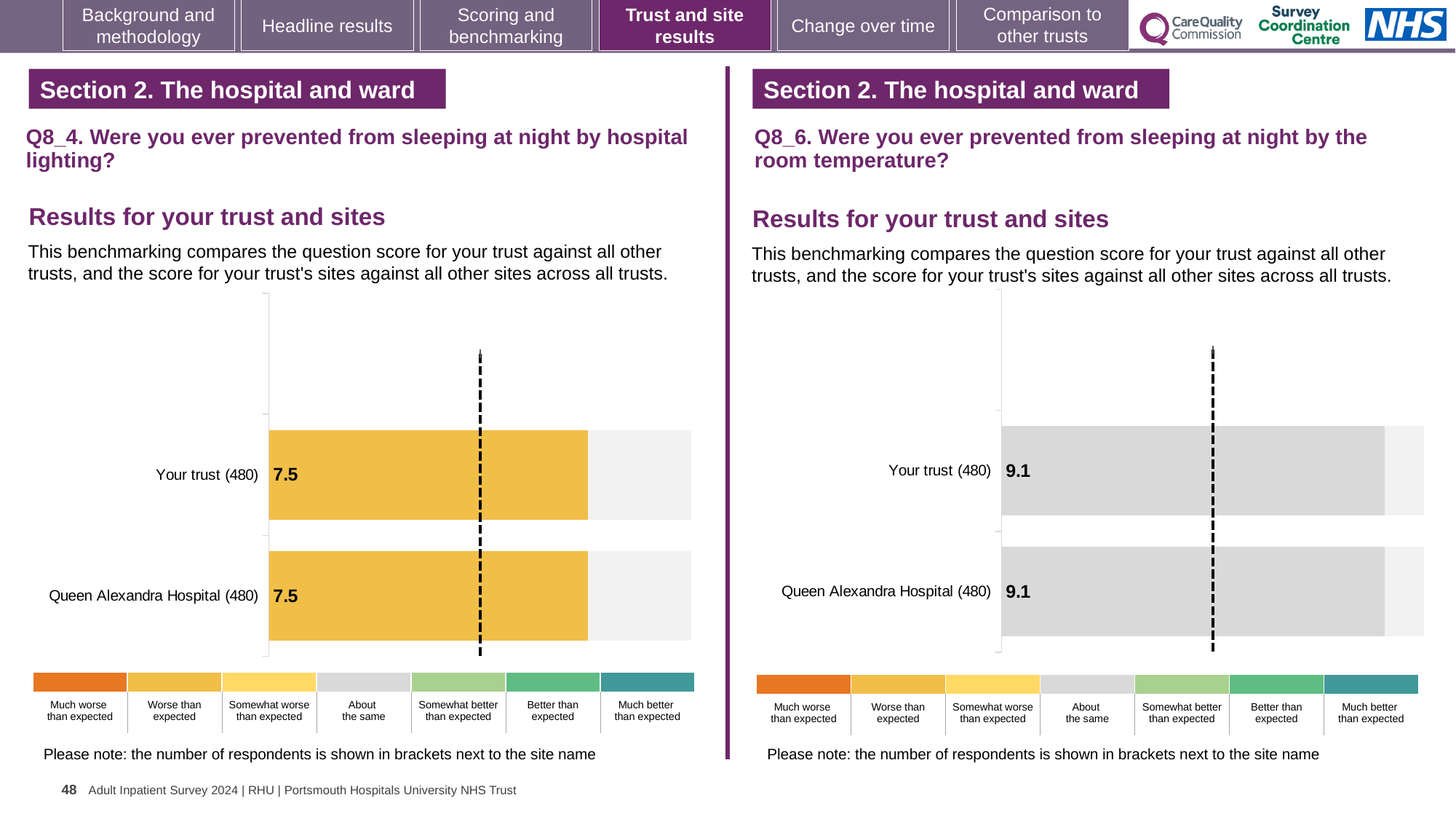
How many bars are plotted in the Q8_6 chart (room temperature)? 2 In the Q8_4 chart (hospital lighting), what is the score for Your trust (480)? 7.5 What kind of chart is used for the Q8_6 results (room temperature)? Bar chart In the Q8_6 chart (room temperature), what is the score for Queen Alexandra Hospital (480)? 9.1 In the Q8_4 chart (hospital lighting), what is the score for Queen Alexandra Hospital (480)? 7.5 In the Q8_6 chart (room temperature), what is the difference between the scores for Your trust and Queen Alexandra Hospital? 0 In the Q8_4 chart (hospital lighting), which benchmark category does the bar colour correspond to in the key? Worse than expected In the Q8_4 chart (hospital lighting), what is the difference between the scores for Your trust and Queen Alexandra Hospital? 0 In the Q8_6 chart (room temperature), which benchmark category does the bar colour correspond to in the key? About the same Is the score for Your trust in the Q8_6 chart (room temperature) larger or smaller than the score for Your trust in the Q8_4 chart (hospital lighting)? Larger In the Q8_6 chart (room temperature), what is the score for Your trust (480)? 9.1 How many bars are plotted in the Q8_4 chart (hospital lighting)? 2